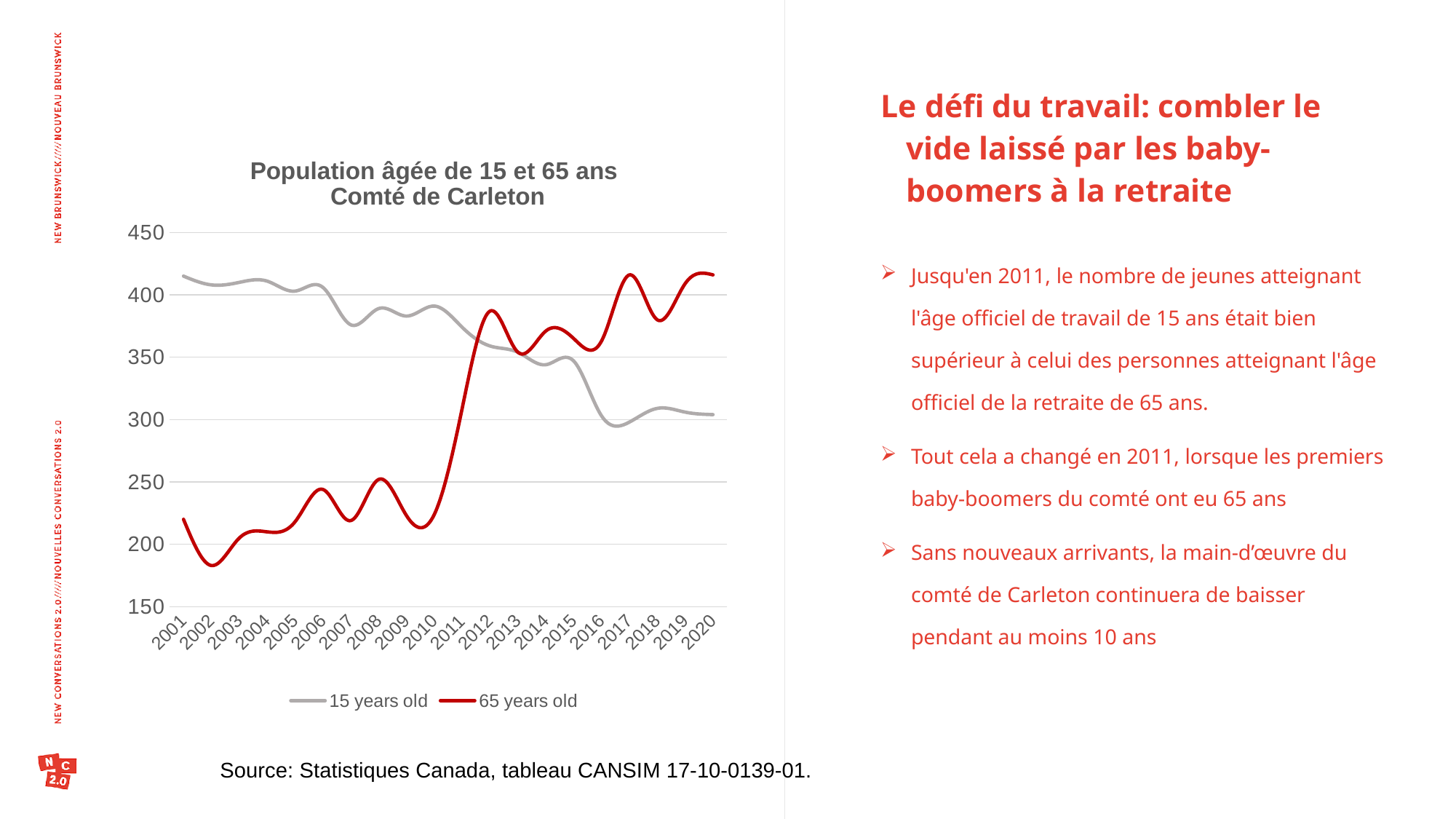
Is the value for 65 years old in 2017 greater or less than 400? greater Is the value for 65 years old in 2002 greater or less than 200? less In 2001, which series has the larger value, 15 years old or 65 years old? 15 years old How many years are plotted along the x axis? 20 Is the value for 15 years old in 2001 greater or less than 400? greater Does the 15 years old series rise or fall overall from 2001 to 2020? fall What is the title of the chart? Population âgée de 15 et 65 ans Comté de Carleton In 2020, which series has the larger value, 15 years old or 65 years old? 65 years old What kind of chart is shown on the slide? line chart Which series is drawn in red? 65 years old How many series does the legend list? 2